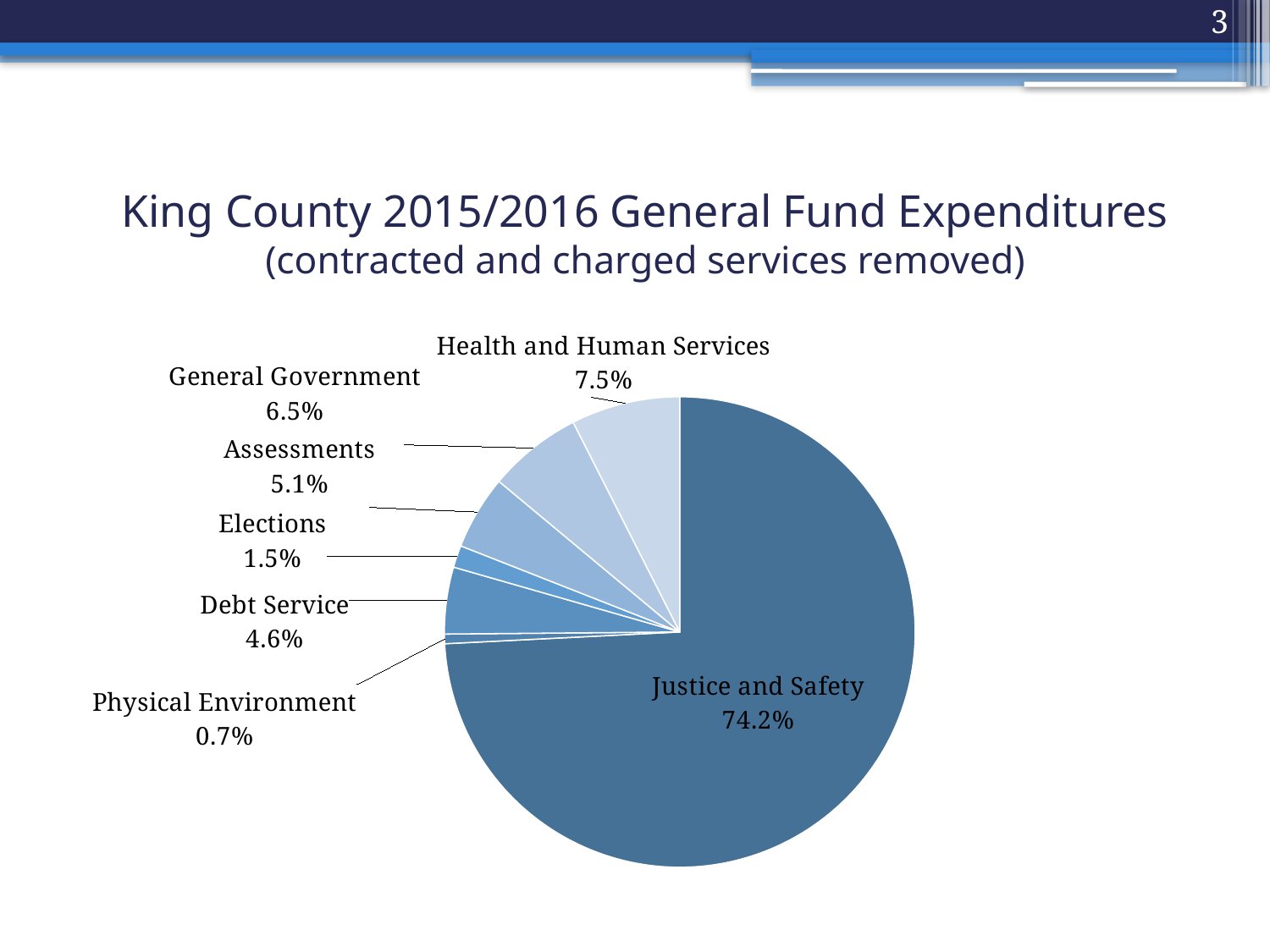
What is the title of the chart on the slide? King County 2015/2016 General Fund Expenditures (contracted and charged services removed) Which category has the smallest slice of the pie? Physical Environment What kind of chart is shown on the slide? Pie chart What percentage is shown for Debt Service? 4.6% What percentage is shown for Elections? 1.5% Which is larger, Assessments or Debt Service? Assessments What percentage is shown for General Government? 6.5% What share of expenditures goes to Justice and Safety? 74.2% How many categories are shown in the pie chart? 7 What percentage is shown for Health and Human Services? 7.5% Which category has the largest slice of the pie? Justice and Safety What is the difference in percentage points between Health and Human Services and General Government? 1.0